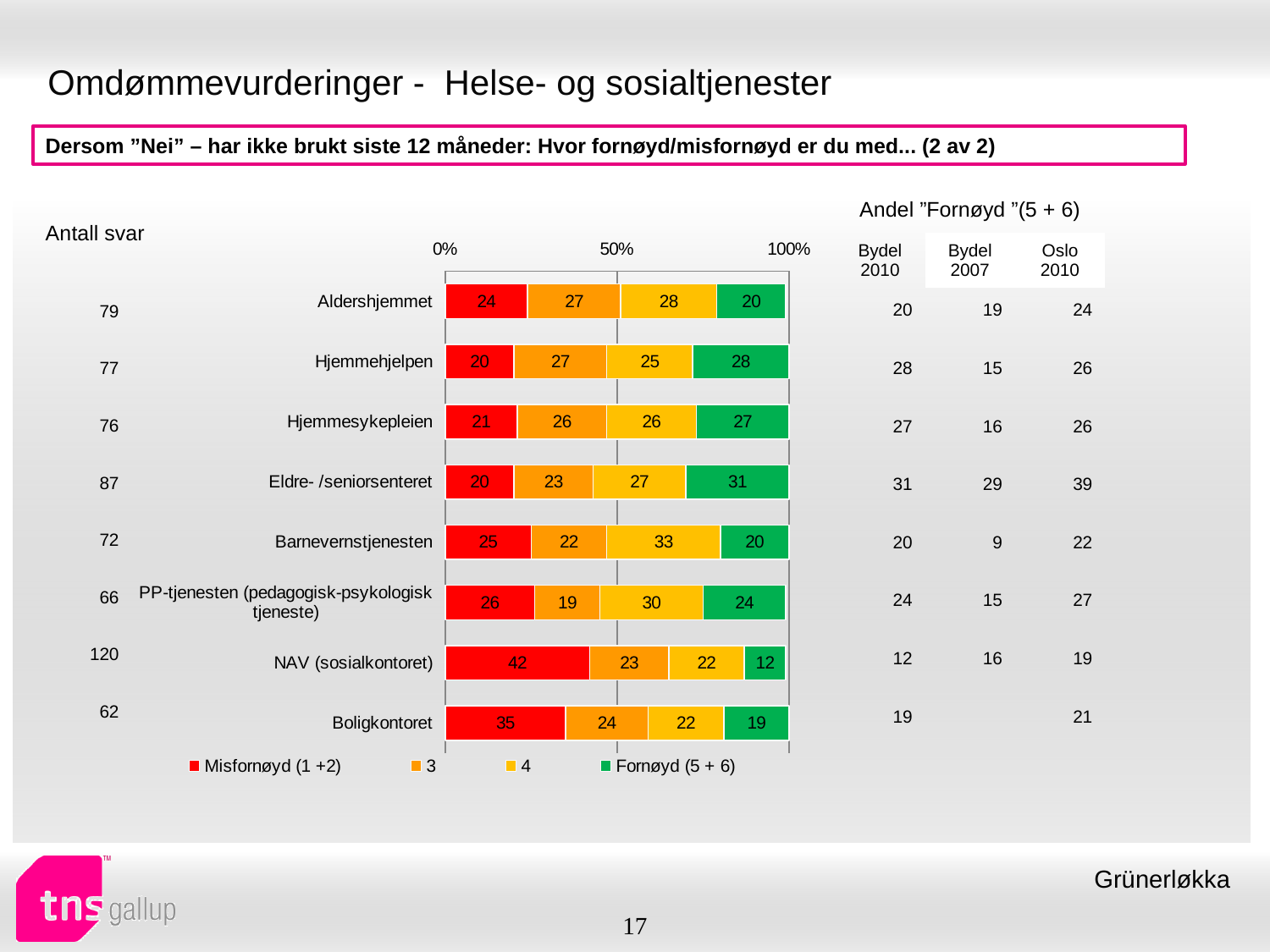
Which category has the lowest Fornøyd (5 + 6) value? NAV (sosialkontoret) What kind of chart is shown on the slide? Stacked bar chart Which has a larger Fornøyd (5 + 6) value, Hjemmehjelpen or Aldershjemmet? Hjemmehjelpen What is the value of the Misfornøyd (1 +2) segment for NAV (sosialkontoret)? 42 What is the total of the four segments for Aldershjemmet? 99 How many series does the legend list? 4 Which category has the highest Misfornøyd (1 +2) value? NAV (sosialkontoret) What is the first entry in the chart's legend? Misfornøyd (1 +2) How many categories are shown in the chart? 8 What is the value of the Fornøyd (5 + 6) segment for Eldre- /seniorsenteret? 31 What is the difference between the Misfornøyd (1 +2) values for NAV (sosialkontoret) and Boligkontoret? 7 What is the value of the '4' segment for Barnevernstjenesten? 33